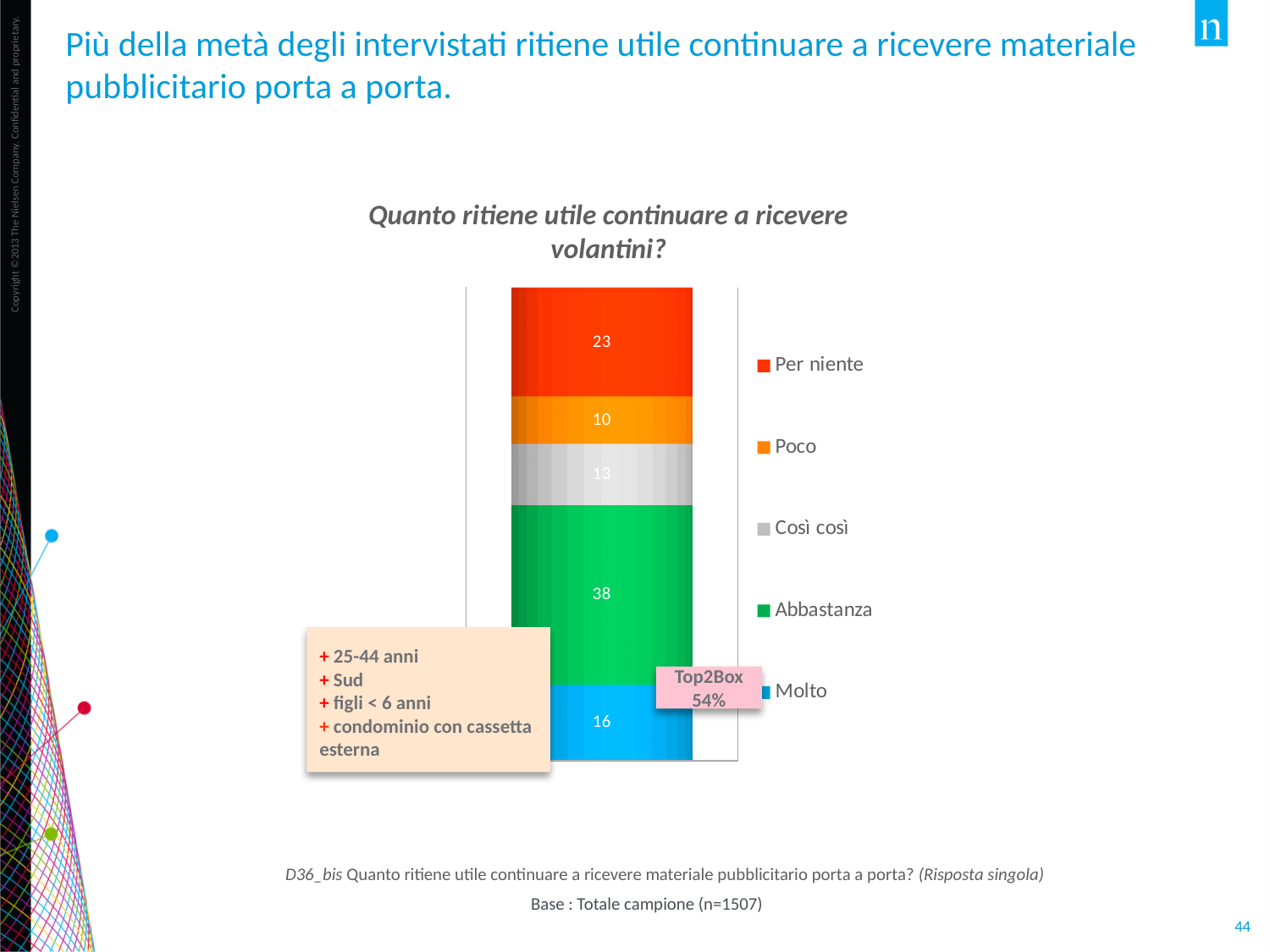
What is the total of all segments in the stacked bar? 100 What value is shown for the "Per niente" segment? 23 Which segment of the stacked bar has the smallest value? Poco What kind of chart is shown on the slide? Stacked bar chart What value is shown for the "Poco" segment? 10 What Top2Box percentage is shown next to the bar? 54% Which is larger, the value for "Così così" or the value for "Poco"? Così così What is the difference between the "Abbastanza" and "Per niente" values? 15 Which segment of the stacked bar has the largest value? Abbastanza What value is shown for the "Molto" segment? 16 What value is shown for the "Abbastanza" segment of the stacked bar? 38 How many series does the legend list? 5